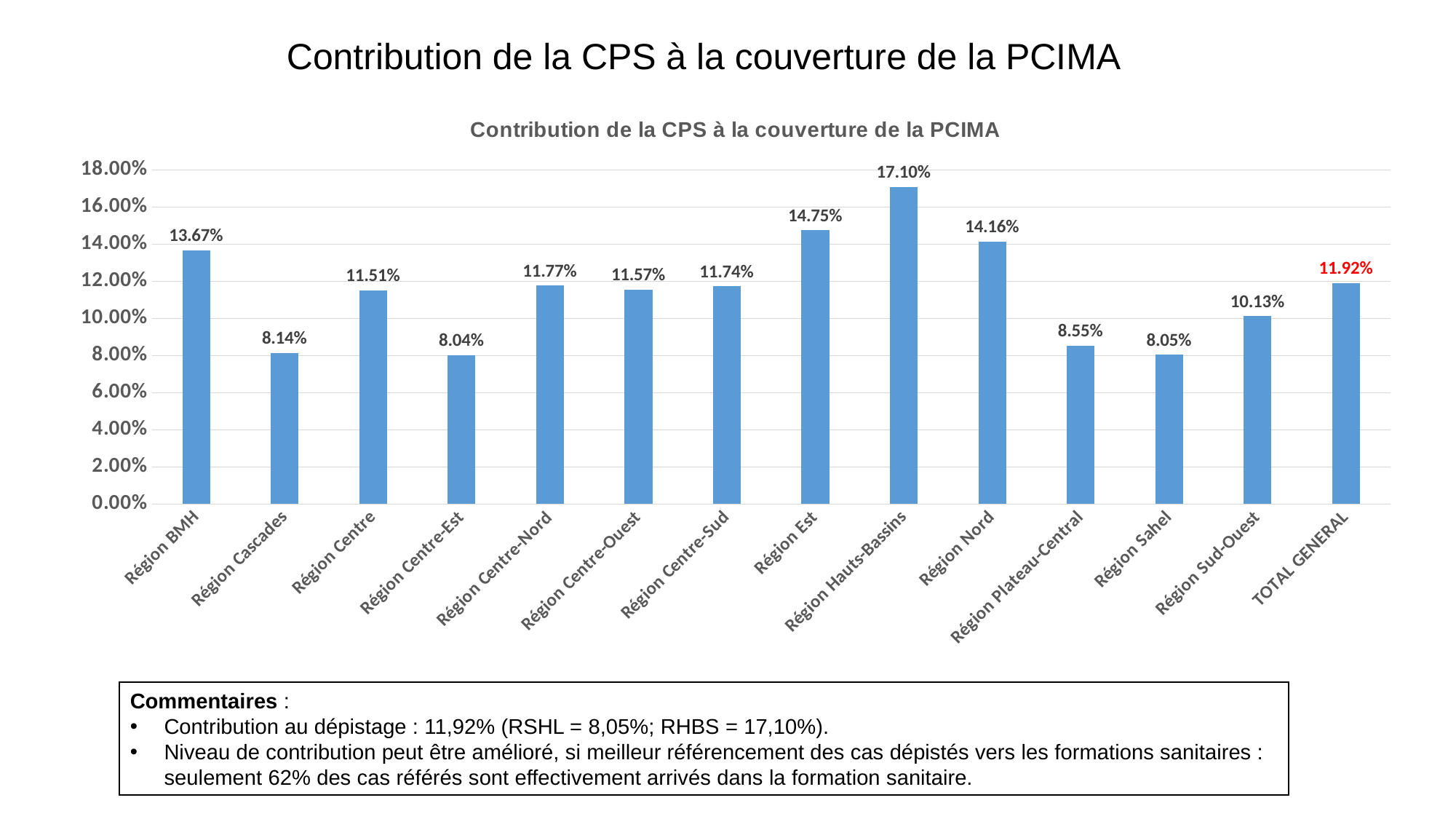
What is the difference between the values for Région Hauts-Bassins and Région Sahel? 9.05% How many categories are shown on the x axis? 14 Which category has the highest value? Région Hauts-Bassins What kind of chart is shown on the slide? bar chart What is the difference between the values for Région BMH and Région Cascades? 5.53% What is the value for Région Hauts-Bassins? 17.10% What is the value for Région Sud-Ouest? 10.13% What is the title of the chart? Contribution de la CPS à la couverture de la PCIMA Is the value for Région Plateau-Central greater or less than 10.00%? less Which is larger, the value for Région Est or the value for Région Nord? Région Est What is the value for TOTAL GENERAL? 11.92% What is the value for Région Centre-Ouest? 11.57%